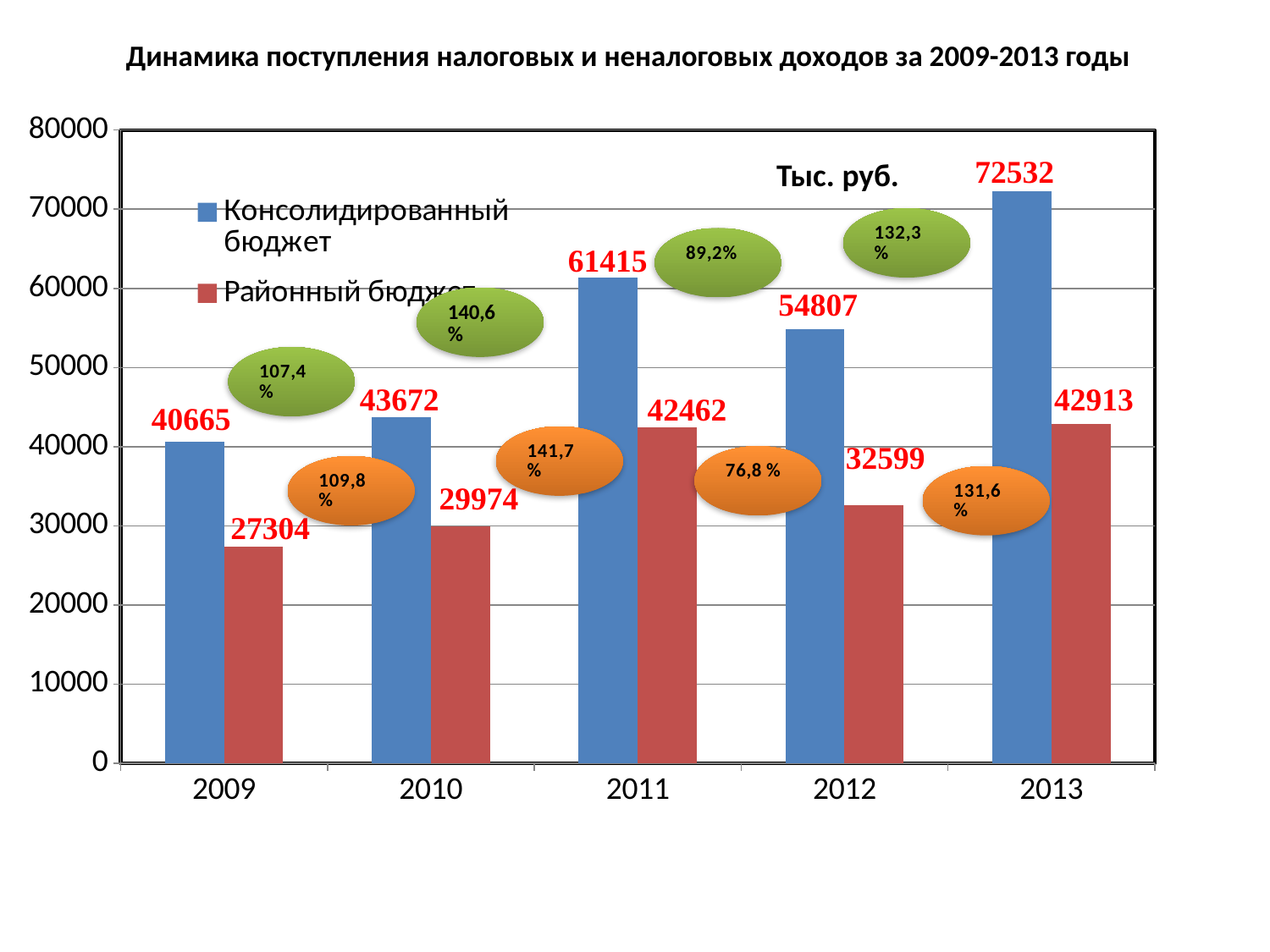
Which is larger: Консолидированный бюджет in 2011 or Консолидированный бюджет in 2012? Консолидированный бюджет in 2011 What is the value for Районный бюджет in 2009? 27304 Is the value for Районный бюджет in 2010 greater or less than 30000? less In which year is Районный бюджет lowest? 2009 How many years are shown on the x axis? 5 What is the value for Консолидированный бюджет in 2013? 72532 What kind of chart is shown on the slide? bar chart What is the difference between Консолидированный бюджет and Районный бюджет in 2012? 22208 What unit is indicated for the values on the chart? Тыс. руб. What is the value for Районный бюджет in 2011? 42462 In which year is Консолидированный бюджет highest? 2013 How many series does the legend list? 2